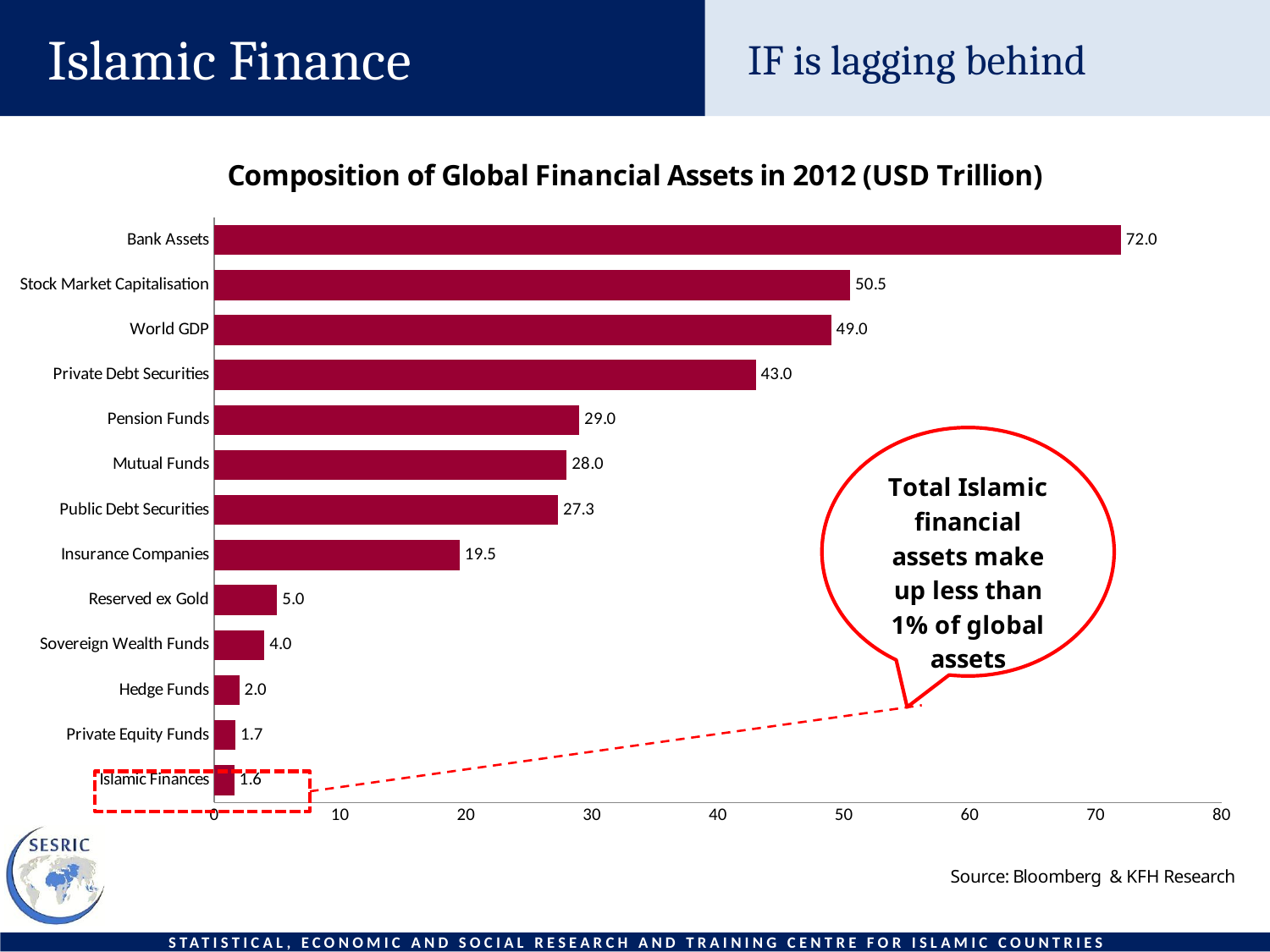
What is the value for Islamic Finances? 1.6 Which category has the highest value? Bank Assets What is the value for Bank Assets? 72.0 Which category has the lowest value? Islamic Finances What is the difference between Stock Market Capitalisation and World GDP? 1.5 How many categories are shown in the chart? 13 Is the value for Public Debt Securities greater or less than 30? less What is the value for Insurance Companies? 19.5 What is the title of the chart? Composition of Global Financial Assets in 2012 (USD Trillion) What is the difference between Bank Assets and Private Debt Securities? 29.0 Which is larger, Pension Funds or Mutual Funds? Pension Funds What kind of chart is shown on the slide? bar chart